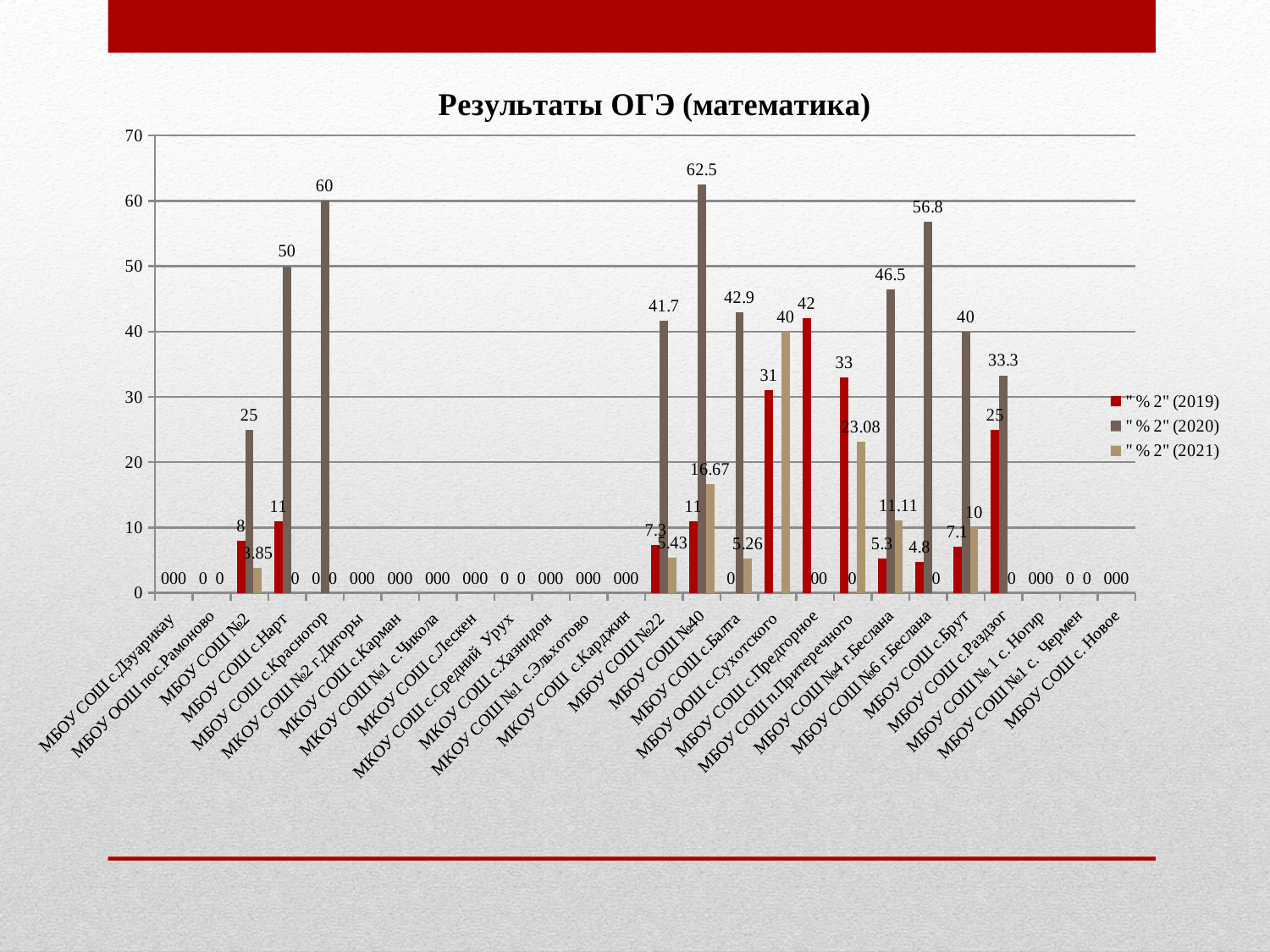
Which is larger: the "% 2" (2020) value for МБОУ СОШ №6 г.Беслана or for МБОУ СОШ №4 г.Беслана? МБОУ СОШ №6 г.Беслана What is the difference between the "% 2" (2020) values for МБОУ СОШ с.Красногор and МБОУ СОШ с.Нарт? 10 Which school has the highest value for "% 2" (2020)? МБОУ СОШ №40 What kind of chart is shown on the slide? bar chart What is the value of "% 2" (2020) for МБОУ СОШ №40? 62.5 What is the value of "% 2" (2021) for МБОУ СОШ №2? 3.85 What is the value of "% 2" (2021) for МБОУ СОШ п.Притеречного? 23.08 Is the "% 2" (2020) value for МБОУ СОШ с.Балта greater or less than 40? greater What is the title of the chart? Результаты ОГЭ (математика) Which school has the highest value for "% 2" (2019)? МБОУ СОШ с.Предгорное How many series does the legend list? 3 What is the value of "% 2" (2019) for МБОУ СОШ с.Предгорное? 42